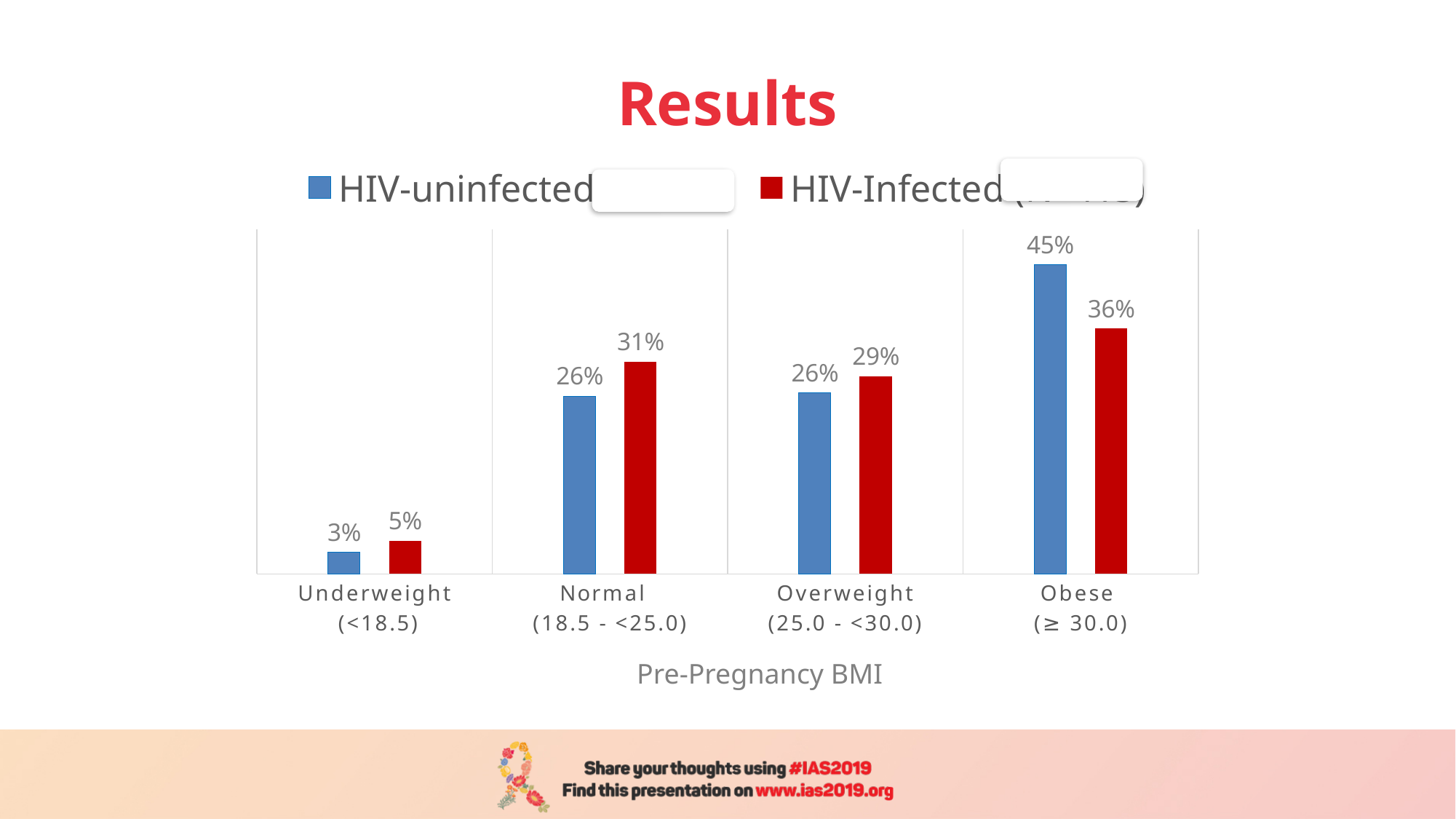
Which BMI category has the lowest value for HIV-Infected women? Underweight (<18.5) What is the difference between the HIV-uninfected and HIV-Infected values in the Obese (≥ 30.0) category? 9% How many series does the legend list? 2 How many pre-pregnancy BMI categories are shown on the x axis? 4 Which BMI category has the highest value for HIV-uninfected women? Obese (≥ 30.0) What is the value for HIV-uninfected women in the Overweight (25.0 - <30.0) category? 26% What is the value for HIV-Infected women in the Underweight (<18.5) category? 5% What percentage of HIV-Infected women had a normal pre-pregnancy BMI (18.5 - <25.0)? 31% What kind of chart is shown on the slide? Bar chart What percentage of HIV-uninfected women were obese (BMI ≥ 30.0)? 45% What is the x-axis title of the chart? Pre-Pregnancy BMI In the Normal (18.5 - <25.0) category, which group has the larger value, HIV-uninfected or HIV-Infected? HIV-Infected